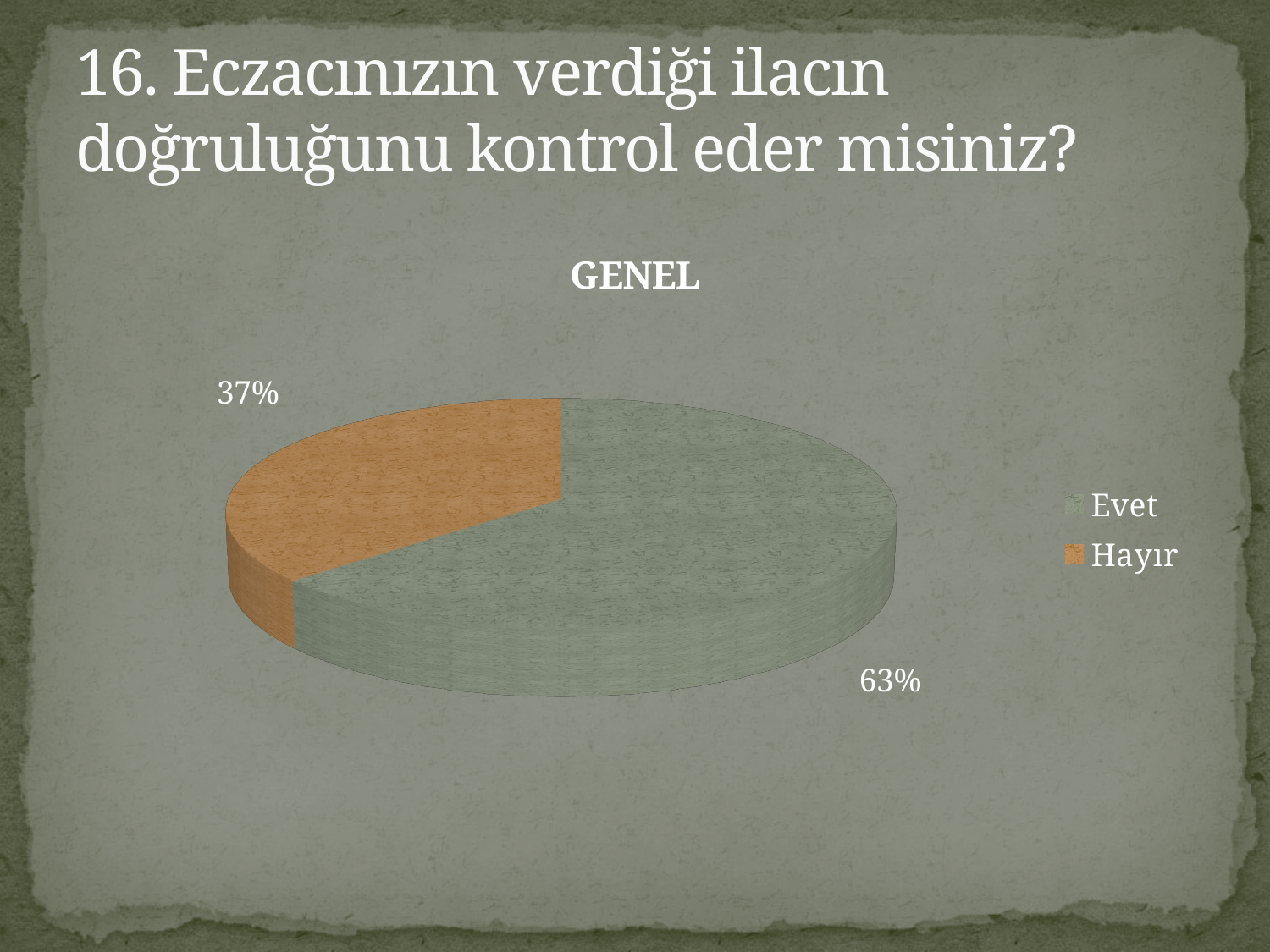
What is the title of the chart? GENEL What is the difference in percentage points between the Evet and Hayır slices? 26 Which slice is larger, Evet or Hayır? Evet What kind of chart is shown on the slide? Pie chart Which colour represents Hayır in the chart? Orange Which category has the smallest slice of the pie? Hayır Which category has the largest slice of the pie? Evet What share of the pie does Hayır represent? 37% What share of the pie does Evet represent? 63% Is the share for Evet greater or less than 50%? greater How many categories does the pie chart show? 2